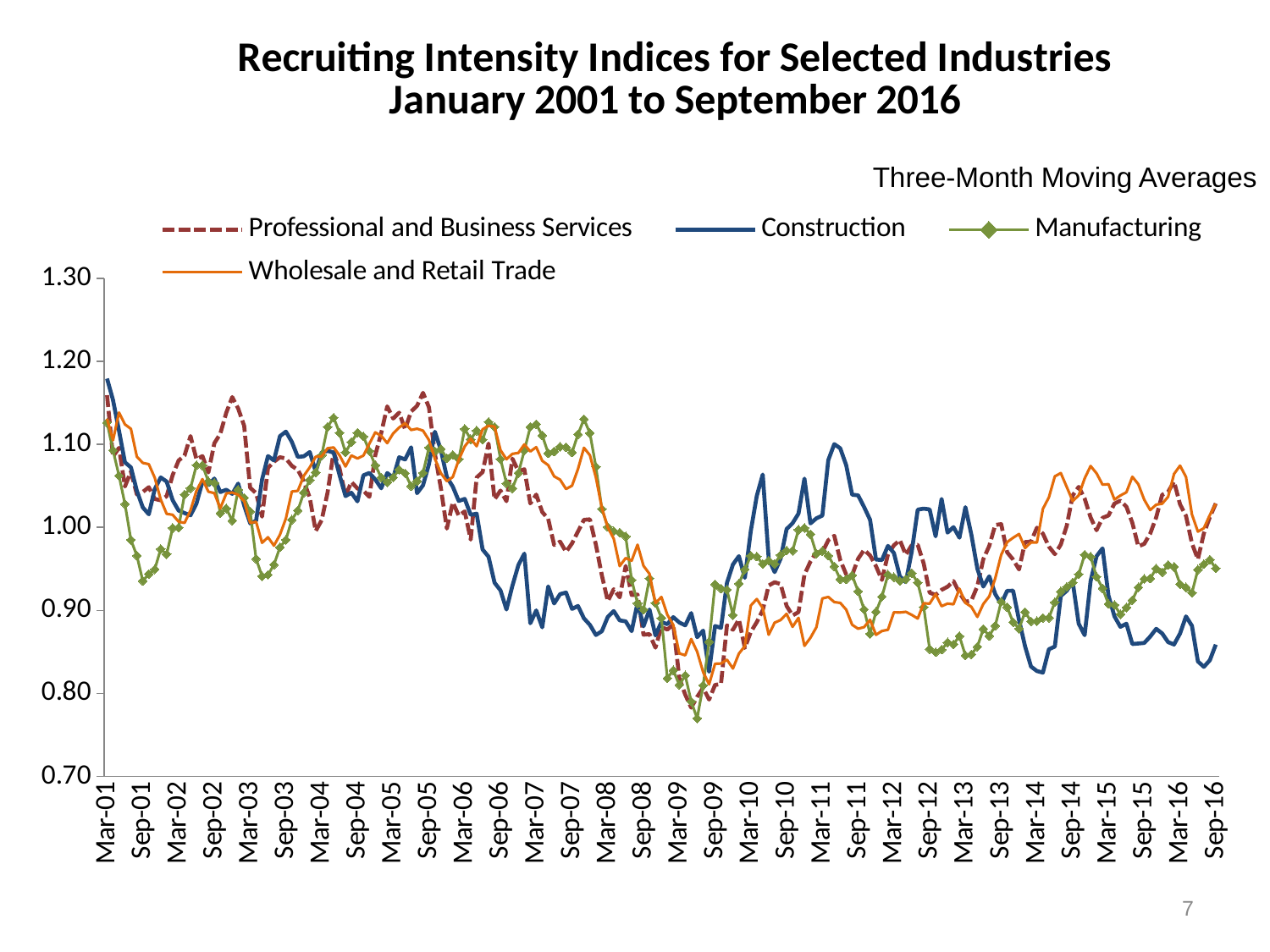
Is the value for Wholesale and Retail Trade at Sep-14 greater or less than 1.00? greater What is the title of the chart? Recruiting Intensity Indices for Selected Industries January 2001 to September 2016 Is the value for Construction at Mar-01 greater or less than 1.10? greater Does the Manufacturing series rise or fall between Mar-08 and Sep-09? fall Is the value for Manufacturing at Sep-12 greater or less than 0.90? less At Mar-11, which is higher: Construction or Wholesale and Retail Trade? Construction At Sep-16, which is higher: Construction or Wholesale and Retail Trade? Wholesale and Retail Trade Which series is drawn with a dashed line? Professional and Business Services How many series does the legend list? 4 What kind of chart is shown on the slide? line chart